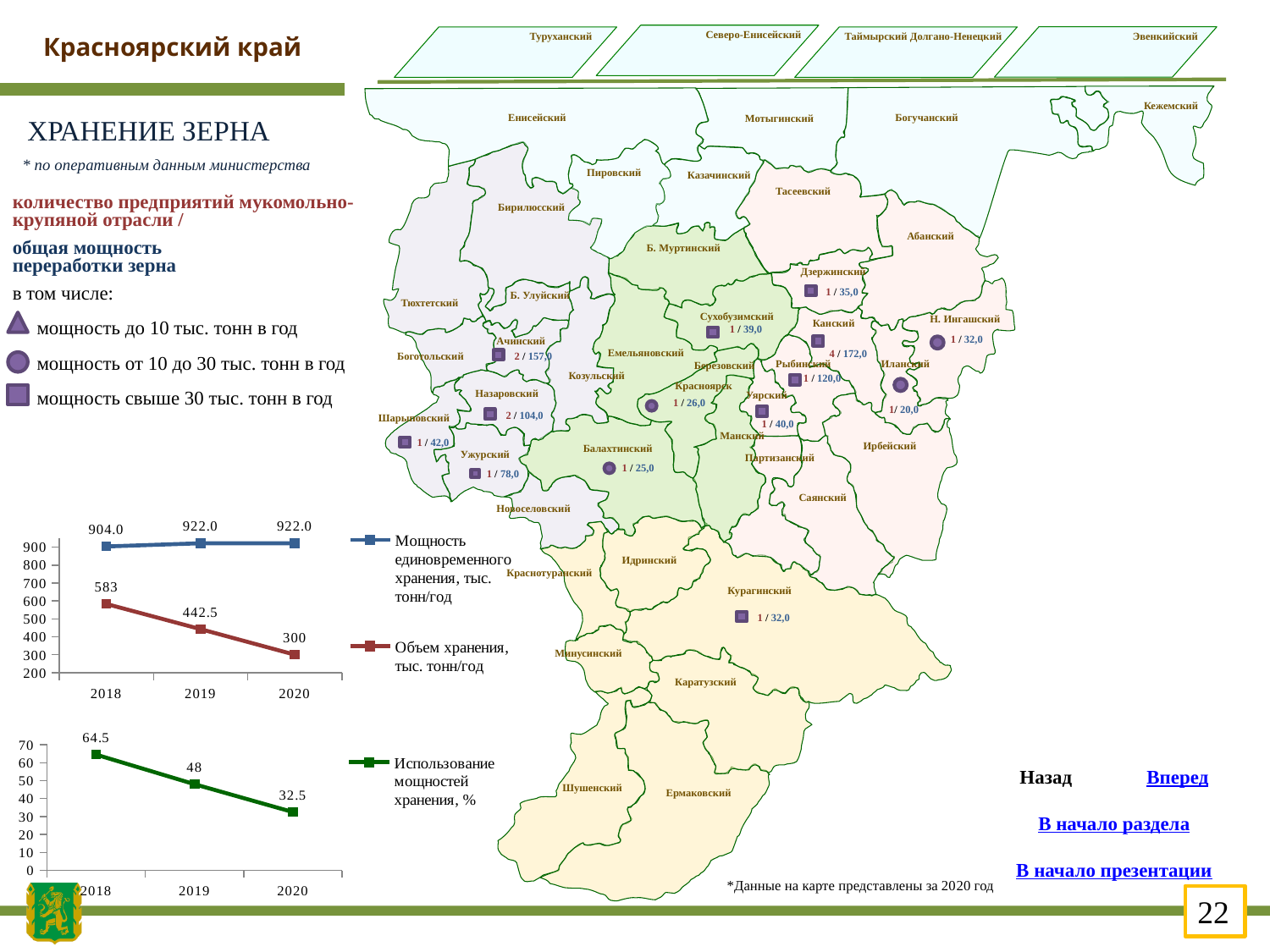
In the lower line chart, what is the value of 'Использование мощностей хранения, %' for 2018? 64.5 In the upper line chart, what is the value of 'Объем хранения, тыс. тонн/год' for 2020? 300 In the upper line chart, in which year is 'Объем хранения, тыс. тонн/год' lowest? 2020 How many series does the legend of the upper line chart list? 2 In the lower line chart, what is the difference between the 2018 and 2019 values of 'Использование мощностей хранения, %'? 16.5 In the lower line chart, what is the value of 'Использование мощностей хранения, %' for 2020? 32.5 How many years are plotted on the x axis of the lower line chart? 3 In the upper line chart, does 'Объем хранения, тыс. тонн/год' rise or fall from 2018 to 2020? fall In the upper line chart, what is the difference between 'Мощность единовременного хранения' and 'Объем хранения' in 2020? 622.0 What kind of chart is the lower chart showing 'Использование мощностей хранения, %'? line chart In the upper line chart, what is the value of 'Мощность единовременного хранения, тыс. тонн/год' for 2018? 904.0 In the upper line chart, what is the value of 'Объем хранения, тыс. тонн/год' for 2019? 442.5